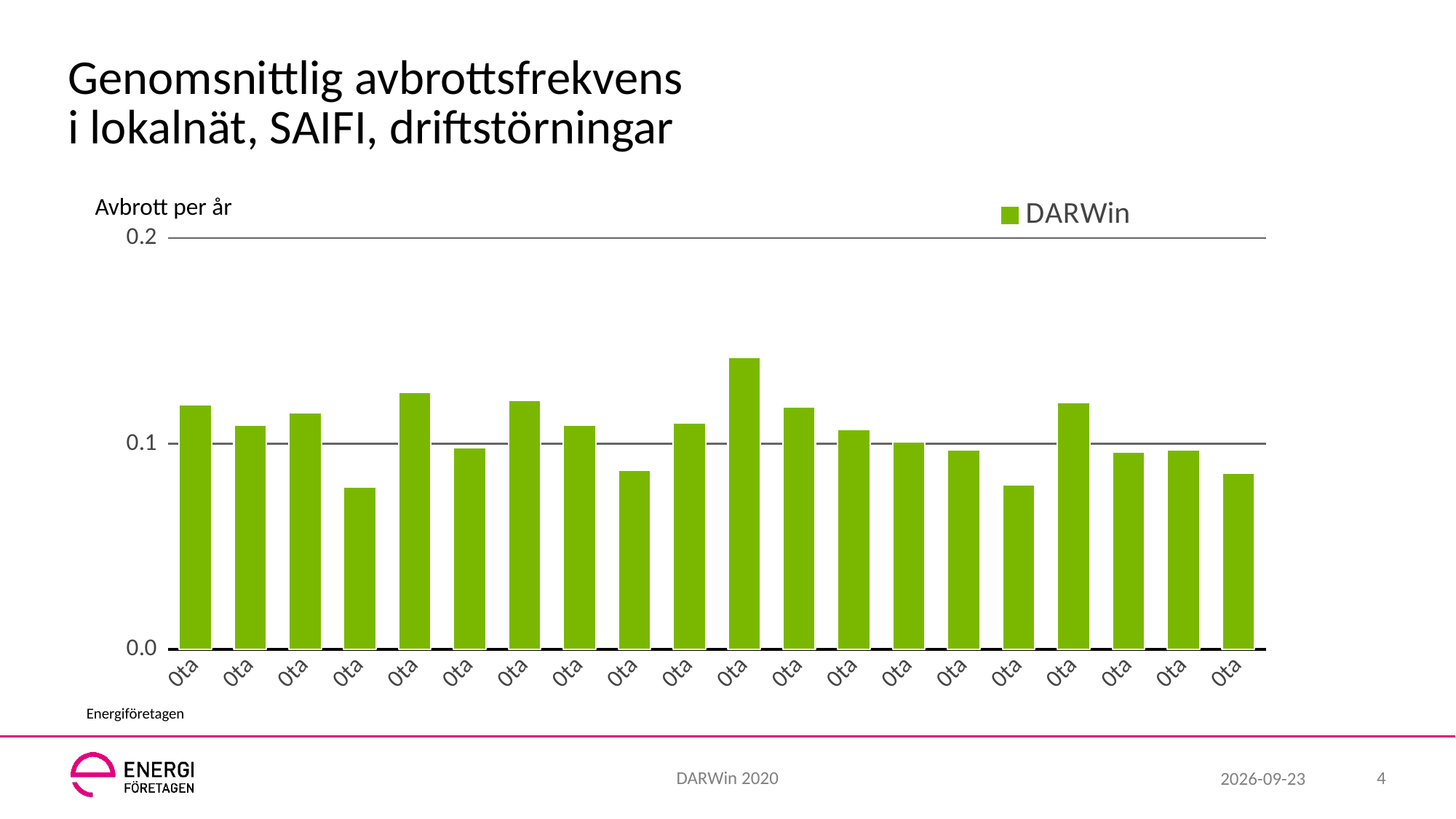
Is the value of the first bar from the left greater or less than 0.1? greater What series name is shown in the chart legend? DARWin What kind of chart is shown on the slide? bar chart Which bar is the highest in the chart? the 11th bar from the left Is the value of the 4th bar from the left greater or less than 0.1? less How many bars are plotted in the chart? 20 Is the value of the tallest bar in the chart greater or less than 0.1? greater How many series does the legend list? 1 What is the label on the vertical axis of the chart? Avbrott per år Which is larger, the 11th bar from the left or the 4th bar from the left? the 11th bar from the left